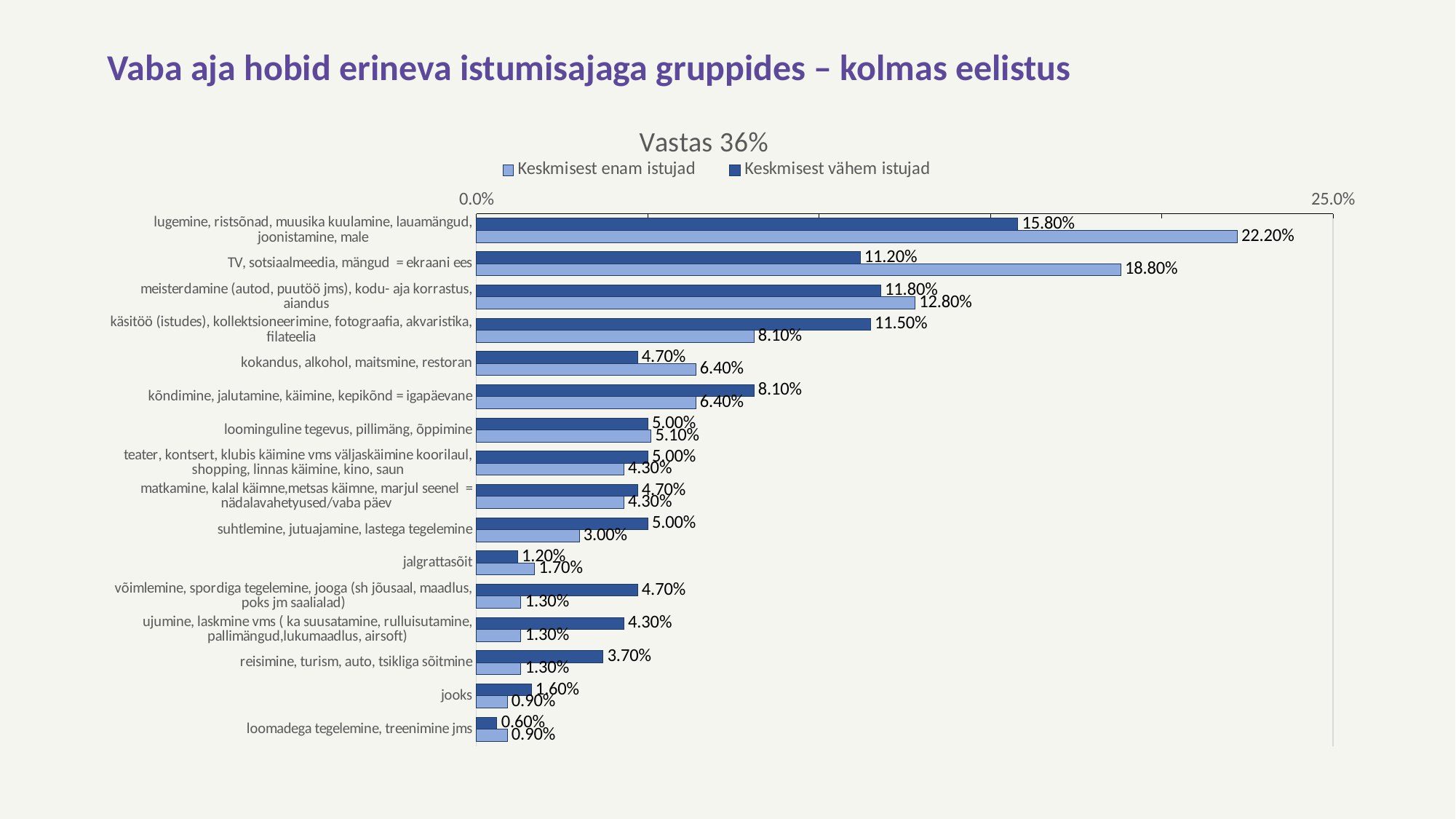
What kind of chart is shown on the slide? Bar chart For "kokandus, alkohol, maitsmine, restoran", which series has the larger value? Keskmisest enam istujad What is the value for "jooks" in the "Keskmisest vähem istujad" series? 1.60% Which category has the lowest value in the "Keskmisest vähem istujad" series? loomadega tegelemine, treenimine jms What is the value for "jalgrattasõit" in the "Keskmisest enam istujad" series? 1.70% What is the difference between the "Keskmisest enam istujad" and "Keskmisest vähem istujad" values for "TV, sotsiaalmeedia, mängud = ekraani ees"? 7.60% What is the title of the chart? Vastas 36% How many categories are shown on the chart? 16 Which category has the highest value in the "Keskmisest enam istujad" series? lugemine, ristsõnad, muusika kuulamine, lauamängud, joonistamine, male For "käsitöö (istudes), kollektsioneerimine, fotograafia, akvaristika, filateelia", which series has the larger value? Keskmisest vähem istujad What is the value for "TV, sotsiaalmeedia, mängud = ekraani ees" in the "Keskmisest vähem istujad" series? 11.20% How many series does the legend list? 2